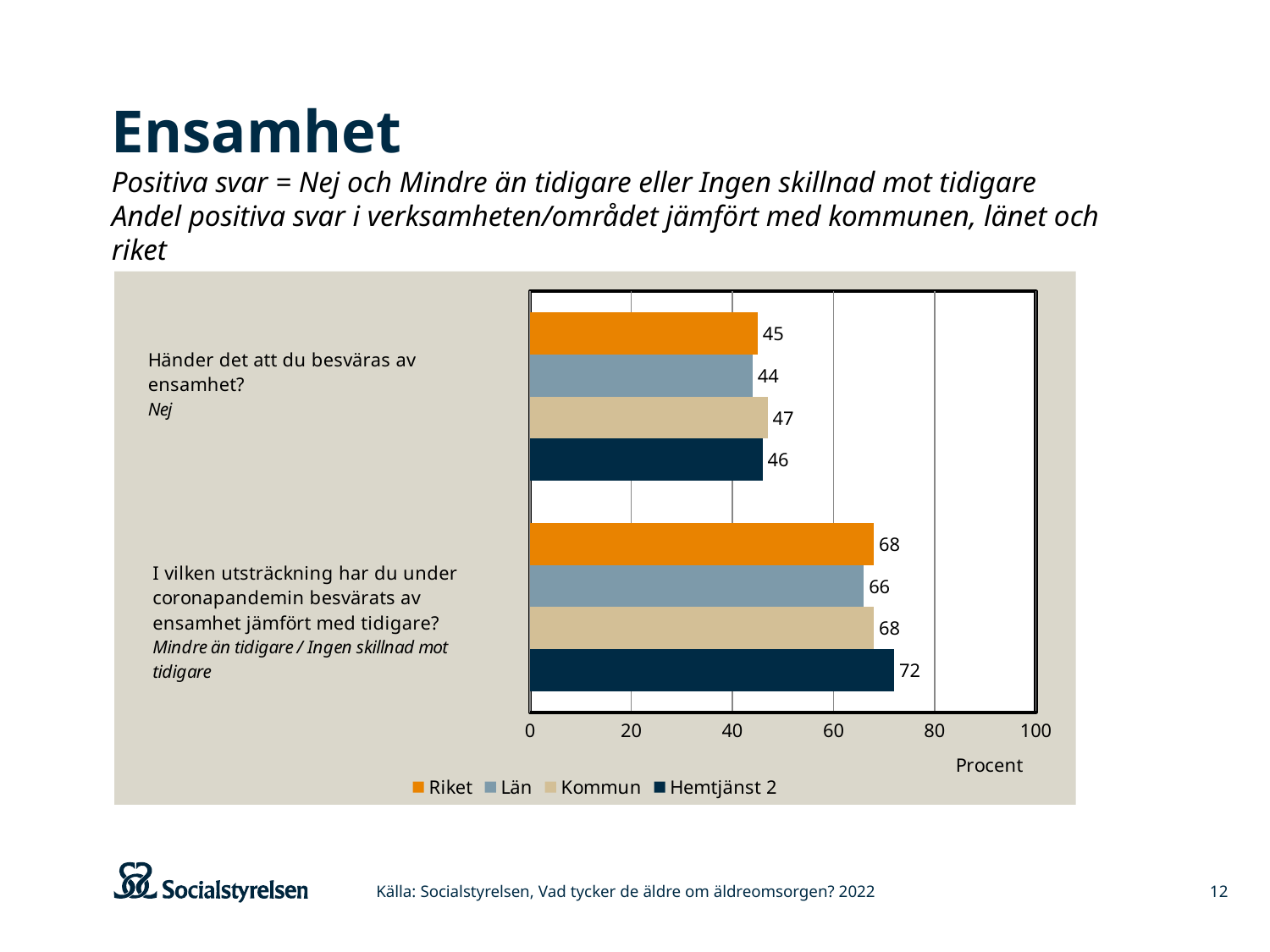
How many series does the legend list? 4 What is the difference between the Hemtjänst 2 value and the Län value for the question "I vilken utsträckning har du under coronapandemin besvärats av ensamhet jämfört med tidigare?"? 6 What is the label on the horizontal axis of the chart? Procent What is the value for Riket for the question "Händer det att du besväras av ensamhet?"? 45 Which is larger for the question "Händer det att du besväras av ensamhet?": the value for Kommun or the value for Riket? Kommun Which series has the highest value for the question "I vilken utsträckning har du under coronapandemin besvärats av ensamhet jämfört med tidigare?"? Hemtjänst 2 What is the value for Län for the question "Händer det att du besväras av ensamhet?"? 44 Is the value for Hemtjänst 2 for the question "Händer det att du besväras av ensamhet?" greater or less than 60? less Which series has the lowest value for the question "Händer det att du besväras av ensamhet?"? Län What is the value for Kommun for the question "I vilken utsträckning har du under coronapandemin besvärats av ensamhet jämfört med tidigare?"? 68 What is the value for Hemtjänst 2 for the question "I vilken utsträckning har du under coronapandemin besvärats av ensamhet jämfört med tidigare?"? 72 What kind of chart is shown on the slide? bar chart